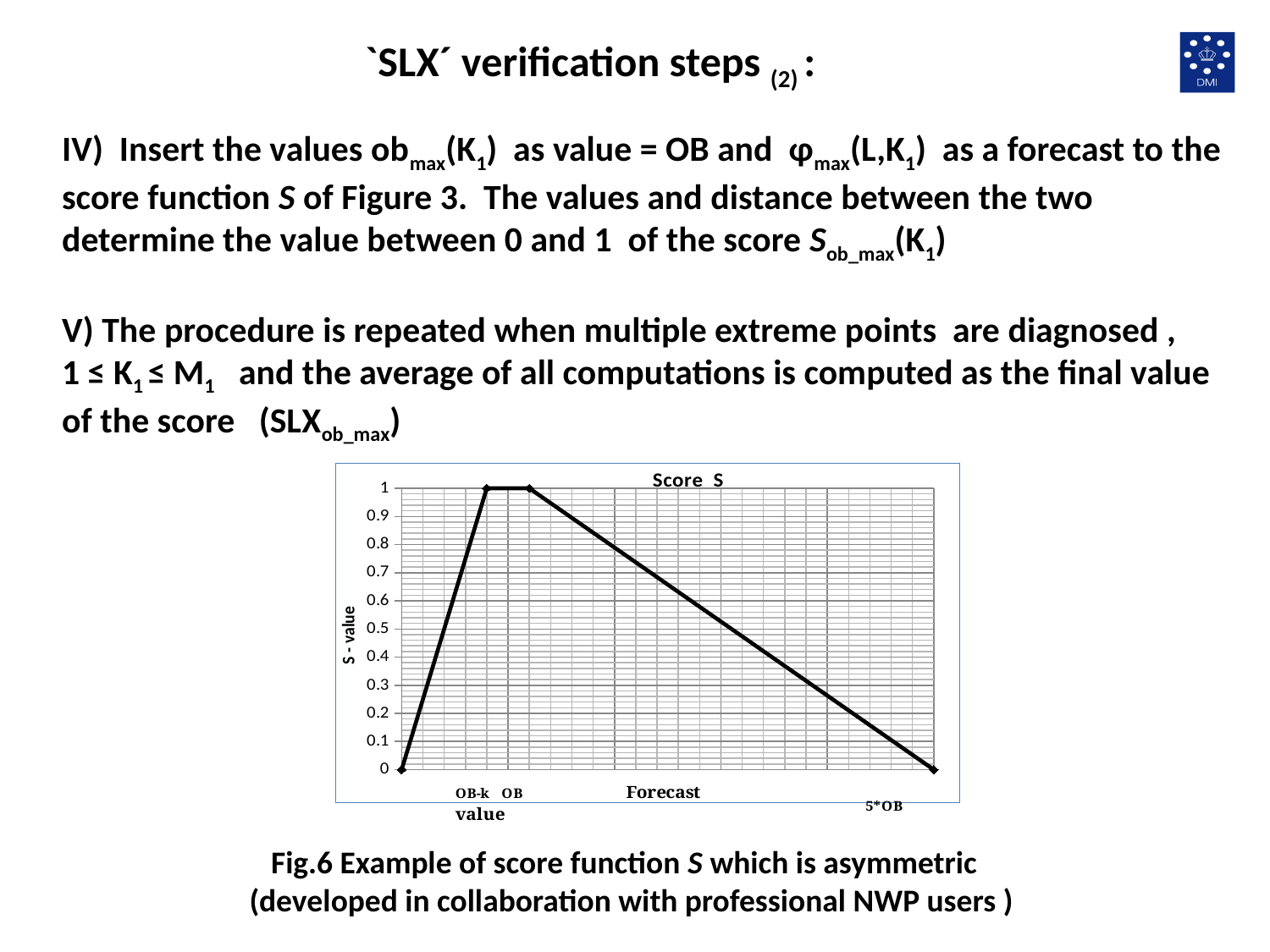
How many marked data points does the line in the chart have? 4 What is the value of the score S at the x-axis point labelled 5*OB? 0 What is the value of the score S at the x-axis point labelled OB? 1 What is the maximum value of the score S shown on the chart? 1 What is the minimum value of the score S shown on the chart? 0 What is the value of the score S at the x-axis point labelled OB-k? 1 What is the title of the chart? Score S Which is larger, the score S at OB or the score S at 5*OB? OB What is the label of the y axis of the chart? S - value Does the score S rise or fall along the x axis between OB and 5*OB? fall What kind of chart is shown on the slide? line chart Does the score S rise or fall along the x axis between the leftmost point and OB-k? rise